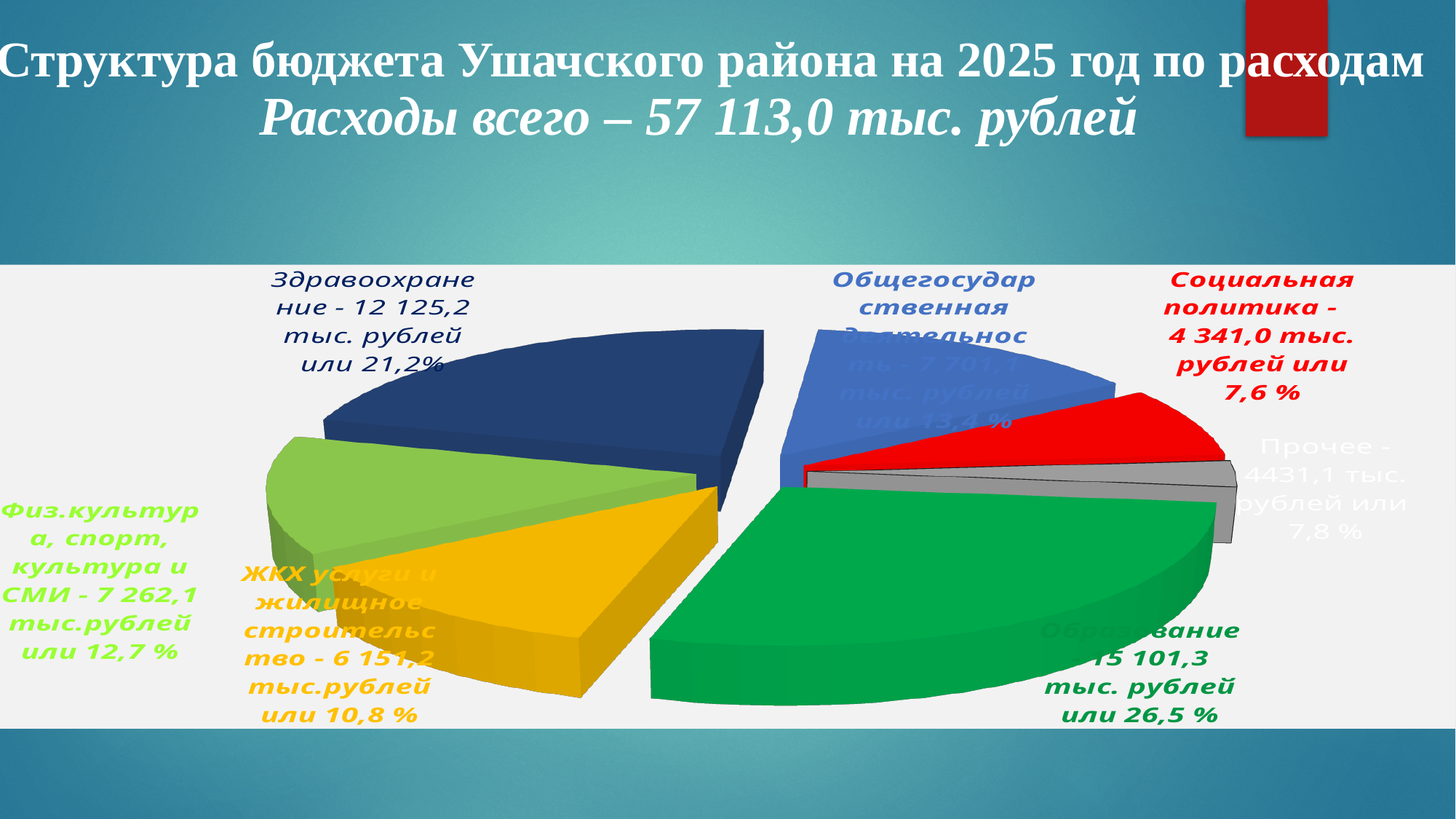
What share of the pie does Здравоохранение represent? 21,2% What share of the pie does ЖКХ услуги и жилищное строительство represent? 10,8 % What total expenditure is stated in the slide title? 57 113,0 тыс. рублей What is the difference between the values for Образование and Здравоохранение? 2 976,1 тыс. рублей How many slices does the pie chart have? 7 What kind of chart is shown on the slide? pie chart Which category has the largest slice of the pie? Образование What share of the pie does Прочее represent? 7,8 % What is the value for Социальная политика? 4 341,0 тыс. рублей What is the value for Образование? 15 101,3 тыс. рублей Which is larger, the value for Физ.культура, спорт, культура и СМИ or the value for Общегосударственная деятельность? Общегосударственная деятельность